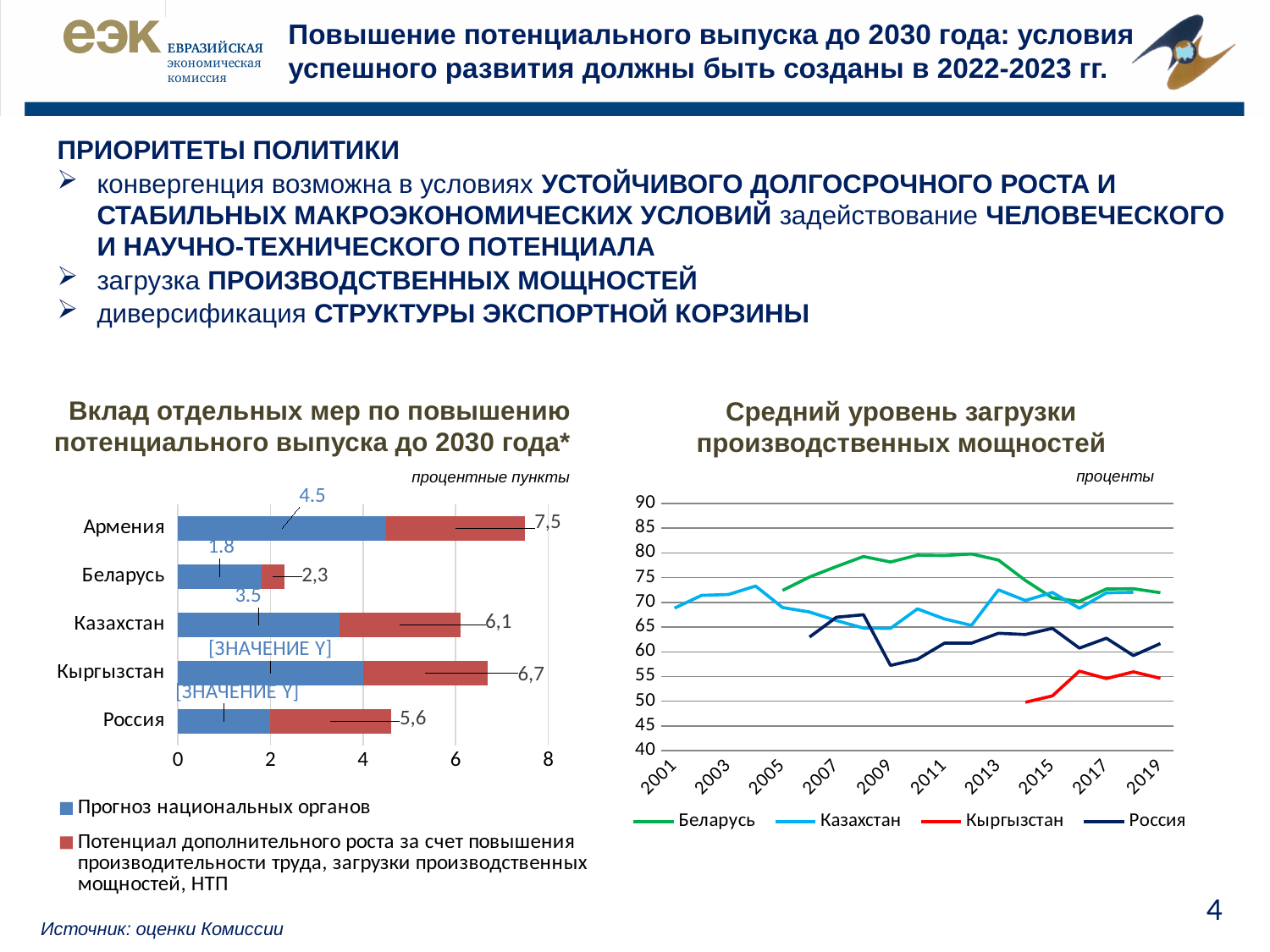
What kind of chart is the right chart, 'Средний уровень загрузки производственных мощностей'? line chart In the left chart 'Вклад отдельных мер по повышению потенциального выпуска до 2030 года*', what is the total value labelled for Армения? 7,5 In the right chart 'Средний уровень загрузки производственных мощностей', is the value for Беларусь in 2009 greater or less than 75? greater In the left chart 'Вклад отдельных мер по повышению потенциального выпуска до 2030 года*', how many series does the legend list? 2 In the left chart 'Вклад отдельных мер по повышению потенциального выпуска до 2030 года*', which country has the highest total value? Армения In the left chart 'Вклад отдельных мер по повышению потенциального выпуска до 2030 года*', how many countries are shown? 5 In the left chart 'Вклад отдельных мер по повышению потенциального выпуска до 2030 года*', which country has the lowest total value? Беларусь In the right chart 'Средний уровень загрузки производственных мощностей', how many series does the legend list? 4 In the left chart 'Вклад отдельных мер по повышению потенциального выпуска до 2030 года*', which has the larger total value, Казахстан or Кыргызстан? Кыргызстан What kind of chart is the left chart, 'Вклад отдельных мер по повышению потенциального выпуска до 2030 года*'? bar chart In the right chart 'Средний уровень загрузки производственных мощностей', which country has the lowest value in 2019? Кыргызстан In the left chart 'Вклад отдельных мер по повышению потенциального выпуска до 2030 года*', what is the value of 'Прогноз национальных органов' for Беларусь? 1.8